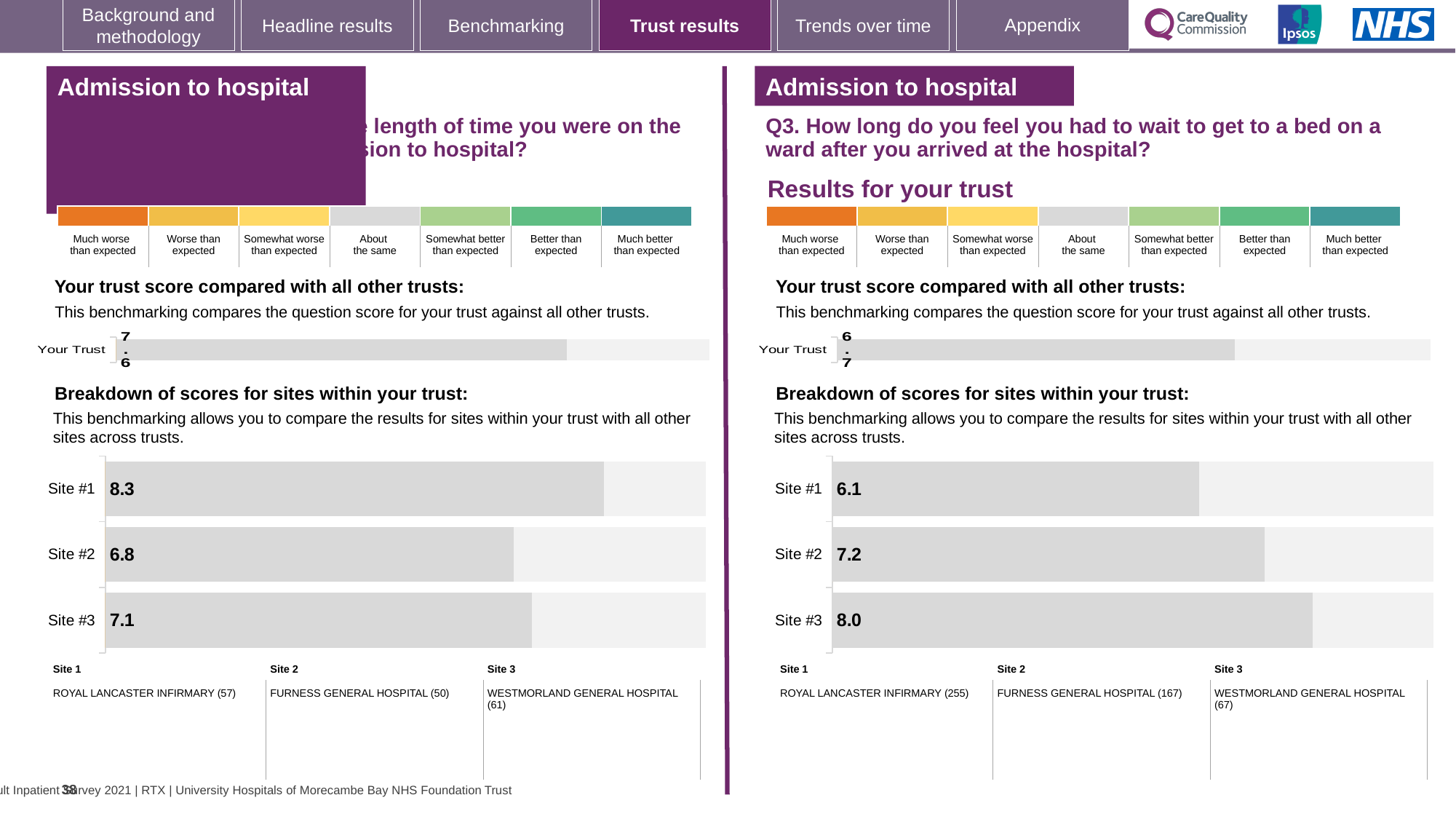
In the left-hand site breakdown chart, what is the score for Site #1? 8.3 In the left-hand site breakdown chart, which site has the lowest score? Site #2 In the left-hand site breakdown chart, what is the score for Site #2? 6.8 In the right-hand (Q3) site breakdown chart, which site has the highest score? Site #3 In the left-hand site breakdown chart, what is the difference between the scores for Site #1 and Site #2? 1.5 In the left-hand site breakdown chart, which site has the highest score? Site #1 In the right-hand (Q3) site breakdown chart, what is the score for Site #3? 8.0 In the right-hand (Q3) 'Your trust score compared with all other trusts' chart, what is the score for Your Trust? 6.7 In the right-hand (Q3) site breakdown chart, which site has the lowest score? Site #1 In the right-hand (Q3) site breakdown chart, what is the score for Site #1? 6.1 In the right-hand (Q3) site breakdown chart, what is the difference between the scores for Site #3 and Site #1? 1.9 What kind of chart is used for the site breakdown on the right-hand (Q3) panel? Bar chart